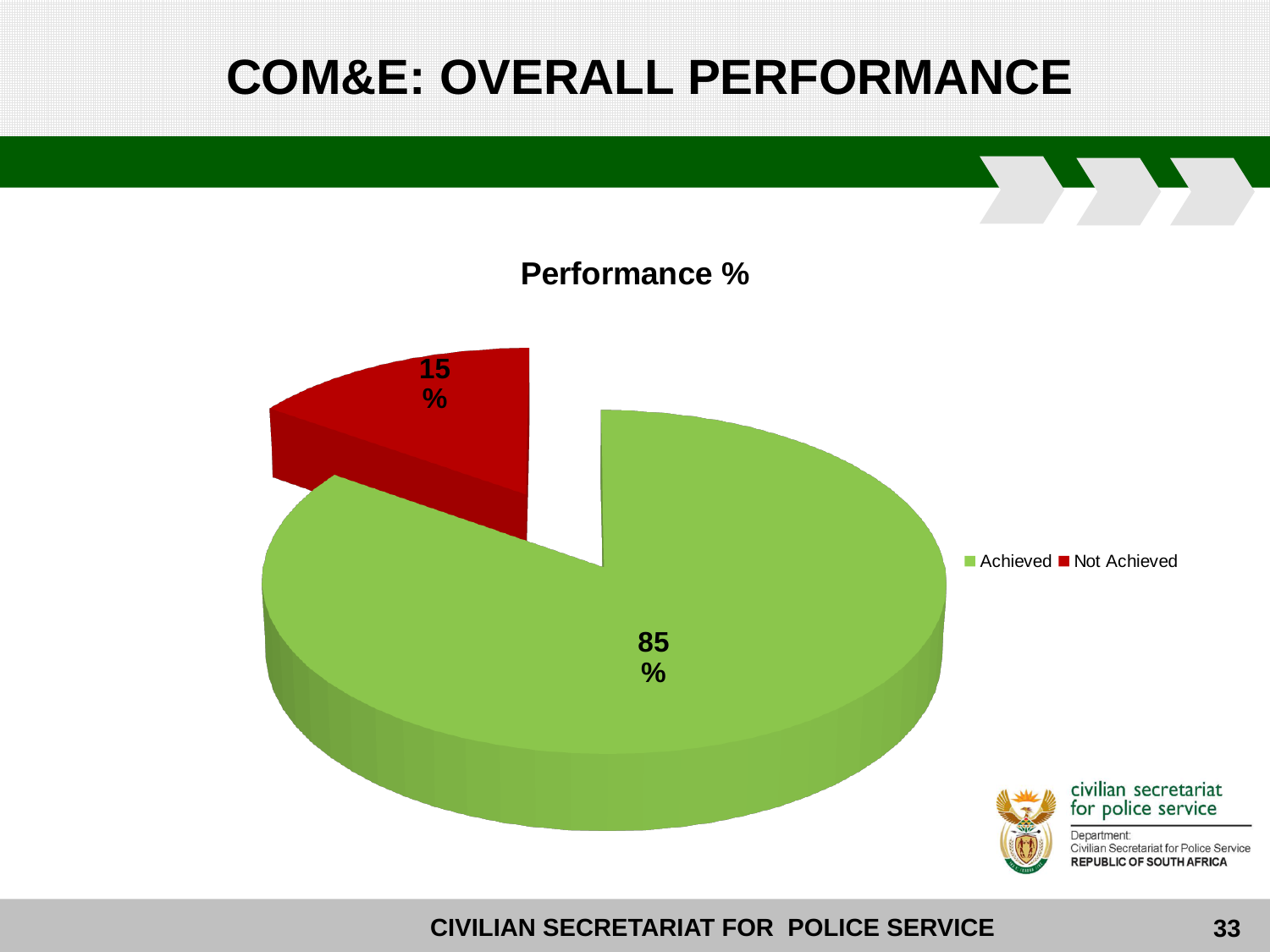
What is the difference in percentage points between the Achieved and Not Achieved slices? 70 What share of the pie does the Achieved slice represent? 85% How many slices does the pie chart have? 2 Which slice is the largest? Achieved What percentage of the pie is labelled Achieved? 85% How many entries does the legend list? 2 Which slice is the smallest? Not Achieved What type of chart is shown on the slide? pie chart What is the title of the chart? Performance % What colour is the Not Achieved slice? red What percentage of the pie is labelled Not Achieved? 15% Which is larger, the Achieved slice or the Not Achieved slice? Achieved